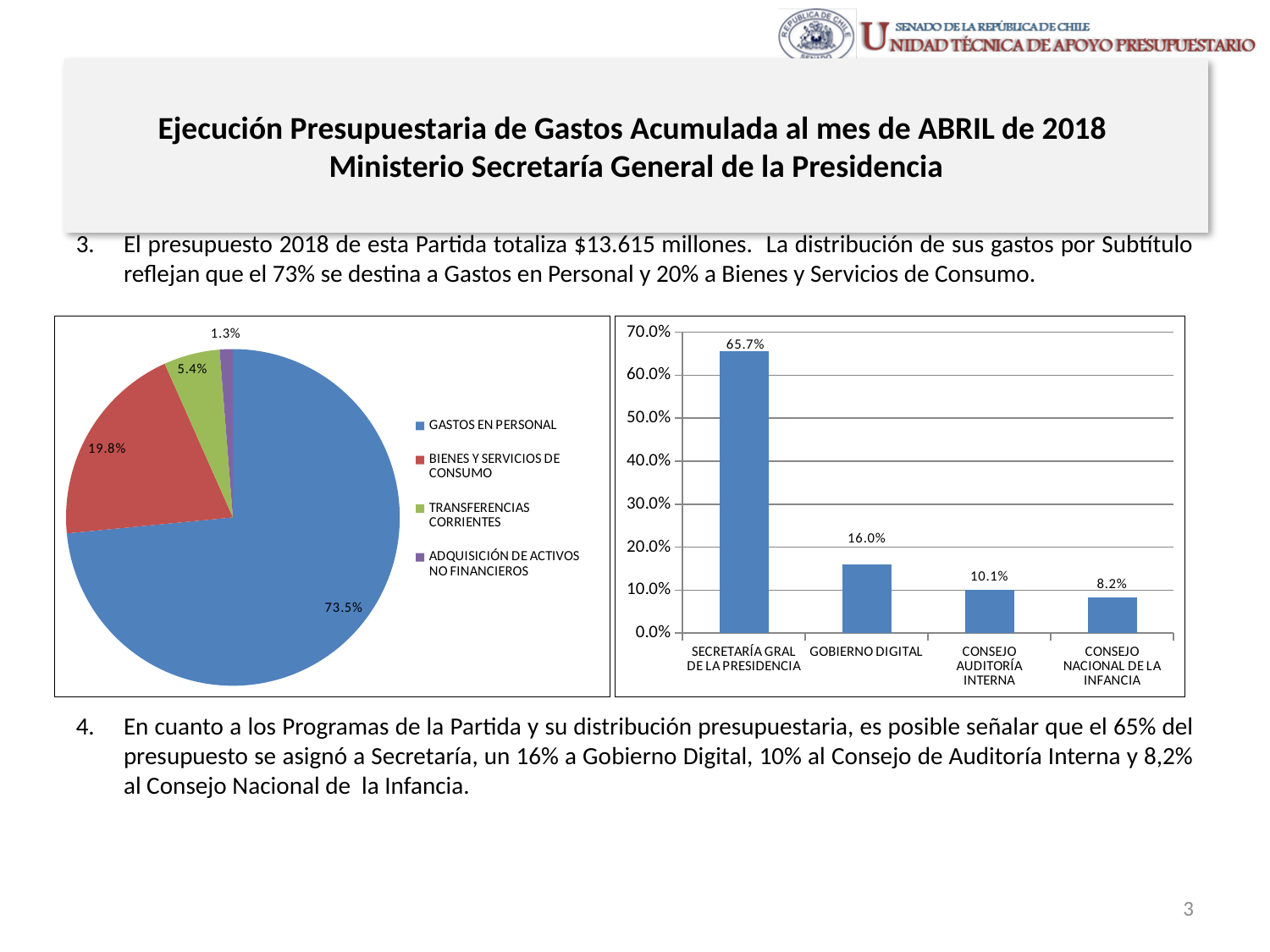
In the pie chart on the left, how many categories does the legend list? 4 In the pie chart on the left, what is the difference between the shares of TRANSFERENCIAS CORRIENTES and ADQUISICIÓN DE ACTIVOS NO FINANCIEROS? 4.1% In the pie chart on the left, what share does GASTOS EN PERSONAL have? 73.5% In the pie chart on the left, what colour is the GASTOS EN PERSONAL slice? Blue In the pie chart on the left, which category has the smallest slice? ADQUISICIÓN DE ACTIVOS NO FINANCIEROS In the bar chart on the right, what is the value for CONSEJO NACIONAL DE LA INFANCIA? 8.2% In the bar chart on the right, which category has the highest value? SECRETARÍA GRAL DE LA PRESIDENCIA In the bar chart on the right, what is the difference between SECRETARÍA GRAL DE LA PRESIDENCIA and CONSEJO AUDITORÍA INTERNA? 55.6% In the bar chart on the right, what is the value for GOBIERNO DIGITAL? 16.0% In the bar chart on the right, do the values rise or fall from left to right along the x axis? Fall In the pie chart on the left, what share does BIENES Y SERVICIOS DE CONSUMO have? 19.8% What kind of chart is shown on the right side of the slide? Bar chart